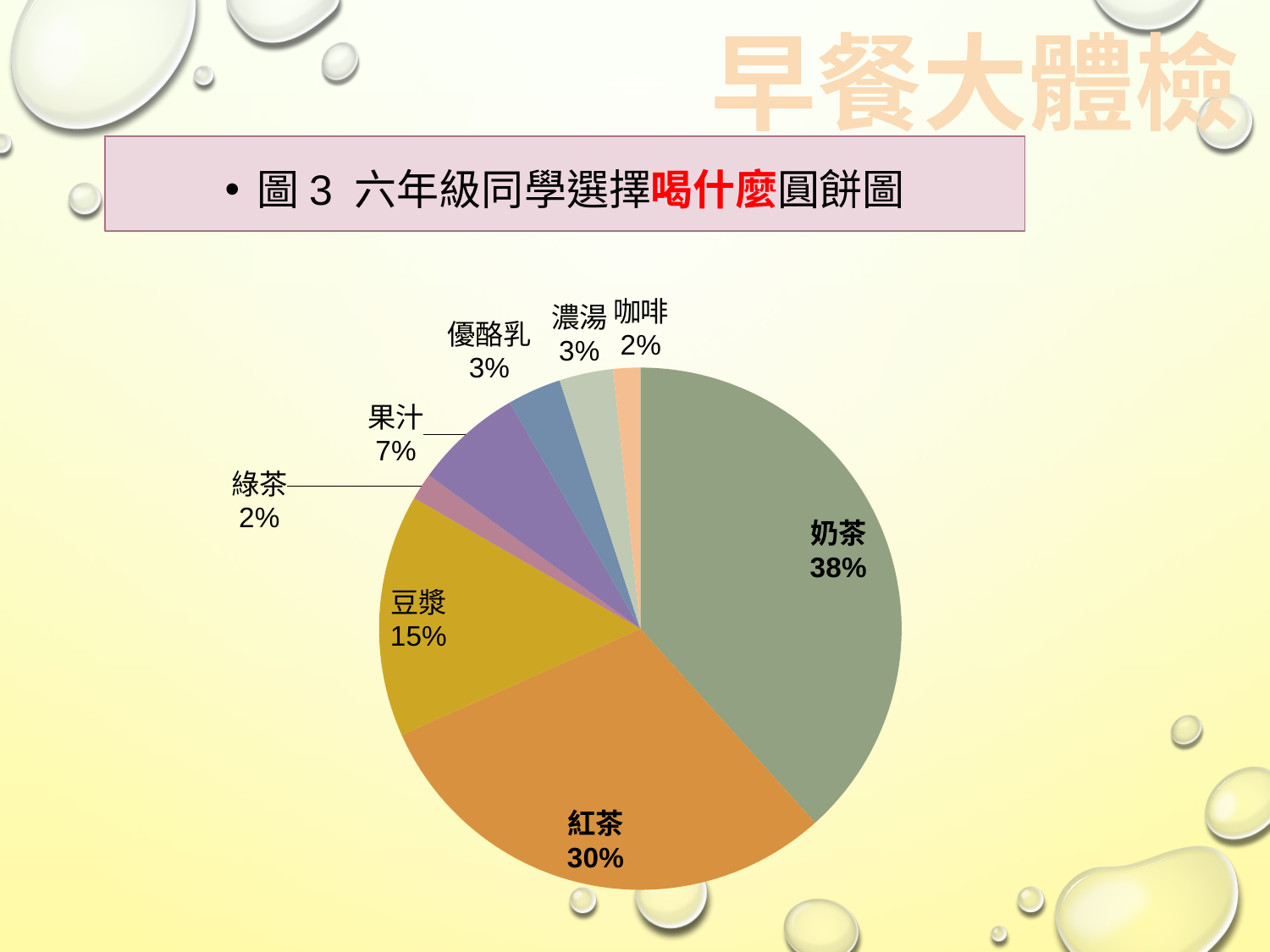
What percentage of the pie chart is 果汁? 7% How many slices does the pie chart have? 8 What is the difference in percentage points between 奶茶 and 紅茶? 8 What percentage of the pie chart is 優酪乳? 3% What percentage of the pie chart is 紅茶? 30% What is the combined share of 綠茶 and 咖啡? 4% What is the title of the chart shown on the slide? 圖 3 六年級同學選擇喝什麼圓餅圖 What percentage of the pie chart is 豆漿? 15% What percentage of the pie chart is 奶茶? 38% Which drink has the largest slice of the pie chart? 奶茶 What type of chart is shown on the slide? pie chart Which is larger, the share for 豆漿 or the share for 果汁? 豆漿